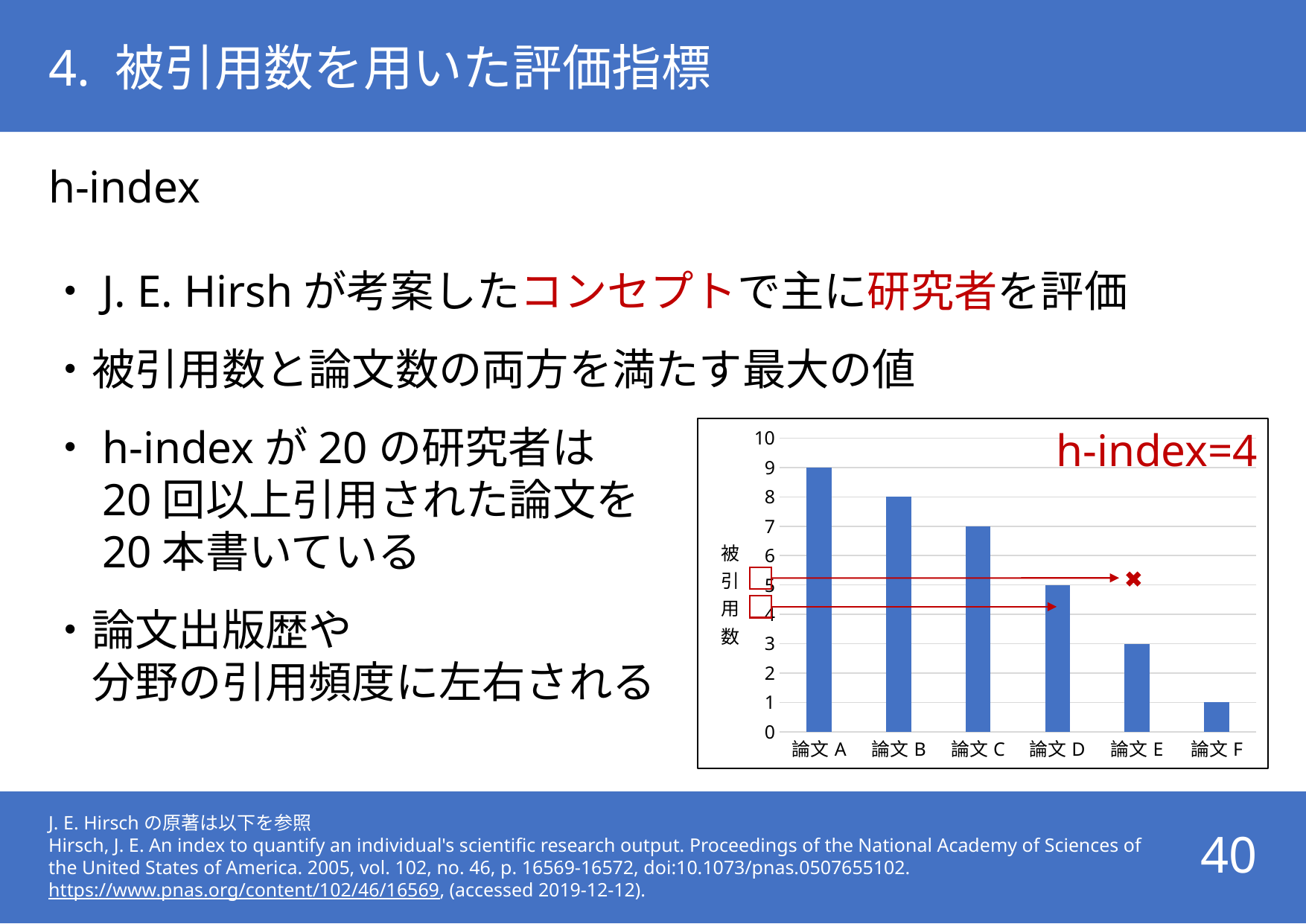
Which has more citations, 論文 C or 論文 D? 論文 C What is the number of citations (被引用数) for 論文 A? 9 What kind of chart is shown on the slide? bar chart Which paper has the highest number of citations? 論文 A How many papers (categories) are plotted on the x axis of the chart? 6 What h-index value is annotated in red on the chart? h-index=4 What is the difference in citations between 論文 B and 論文 E? 5 What is the label on the vertical axis of the chart? 被引用数 What is the number of citations for 論文 D? 5 What is the number of citations for 論文 F? 1 Do the citation counts rise or fall from 論文 A to 論文 F? fall Which paper has the lowest number of citations? 論文 F